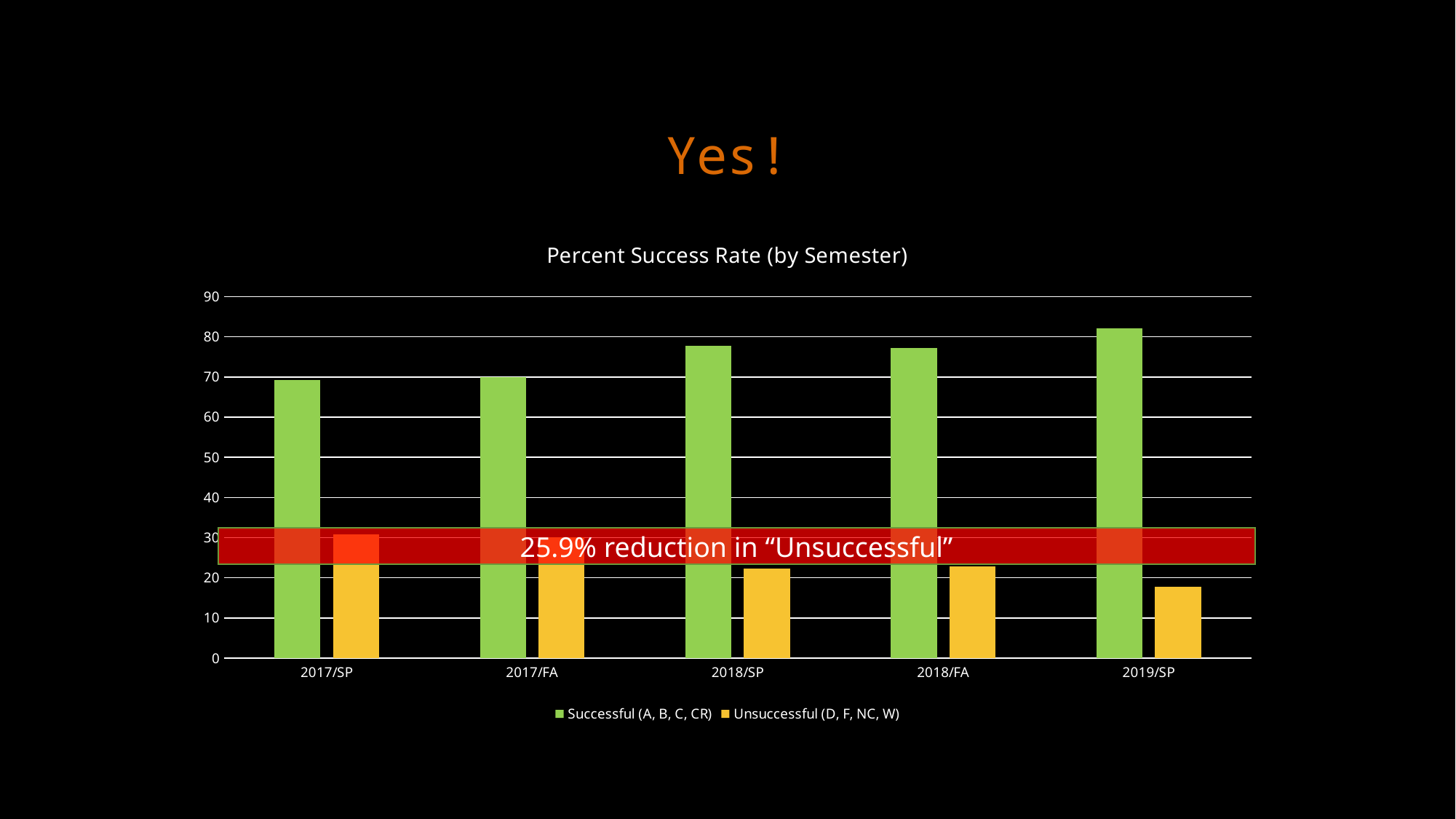
What is the title of the chart? Percent Success Rate (by Semester) What kind of chart is shown on the slide? bar chart Is the Successful (A, B, C, CR) value for 2018/SP greater or less than 70? greater Do the Unsuccessful (D, F, NC, W) values generally rise or fall from 2017/SP to 2019/SP? fall Which semester has the lowest Unsuccessful (D, F, NC, W) value? 2019/SP How many series does the legend list? 2 What reduction in "Unsuccessful" does the annotation on the chart state? 25.9% Is the Unsuccessful (D, F, NC, W) value for 2019/SP greater or less than 20? less How many semesters are shown on the x axis? 5 Which semester has the highest Successful (A, B, C, CR) value? 2019/SP Is the Successful (A, B, C, CR) value for 2019/SP greater or less than 80? greater Which is larger, the Successful (A, B, C, CR) value for 2019/SP or for 2017/SP? 2019/SP